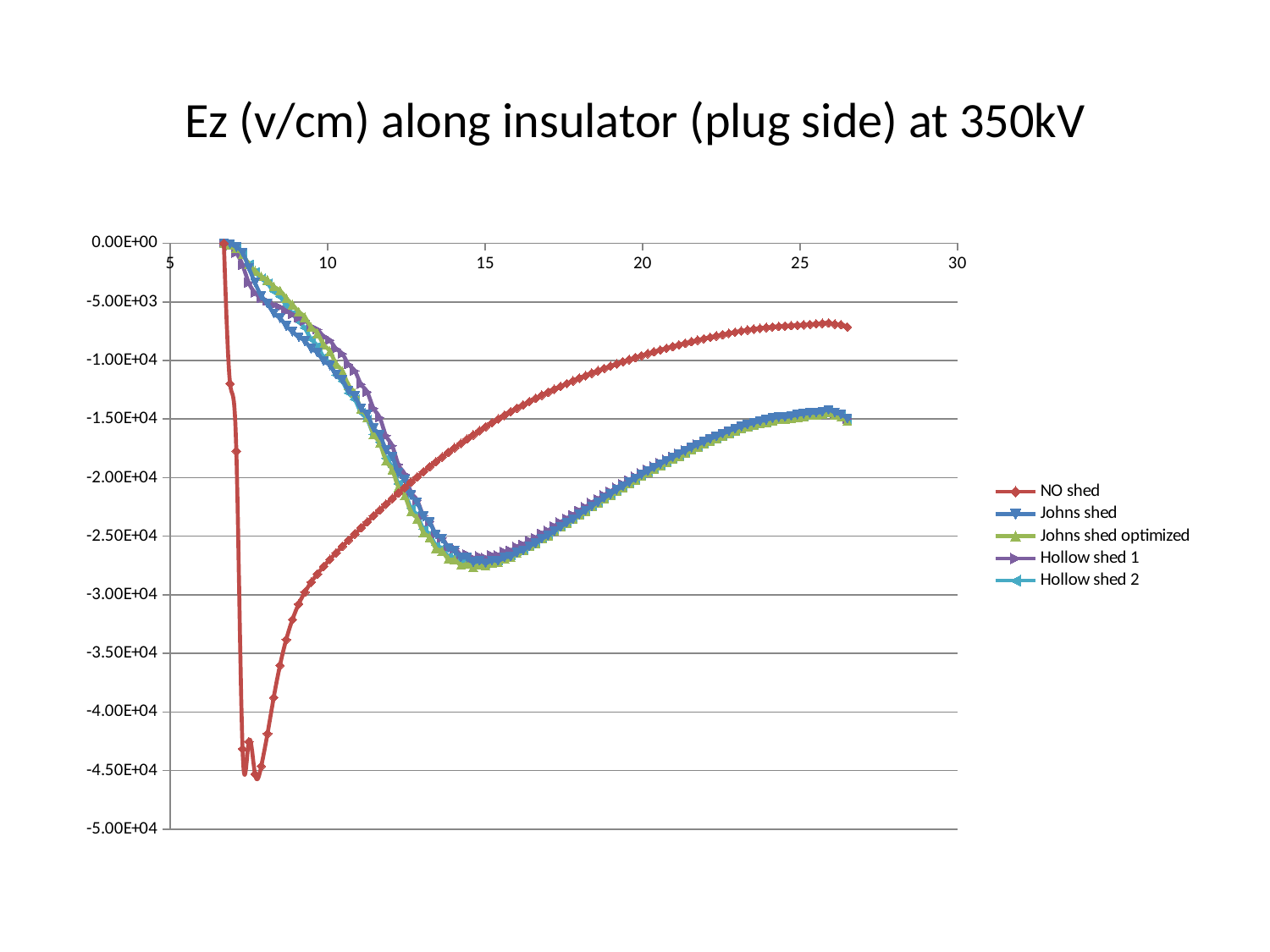
Is the lowest value of the NO shed series greater or less than -4.00E+04? less Which series reaches the lowest (most negative) value on the chart? NO shed Is the value of the NO shed series at x = 25 greater or less than -1.00E+04? greater Between x = 15 and x = 25, does the NO shed series rise or fall? rise At x = 25, which series has the higher value, NO shed or Johns shed? NO shed Is the value of the Johns shed series at x = 25 greater or less than -1.00E+04? less Which series is drawn in red? NO shed How many series does the legend list? 5 What is the title of the chart? Ez (v/cm) along insulator (plug side) at 350kV What kind of chart is shown on the slide? line chart At x = 10, which series has the higher value, NO shed or Johns shed? Johns shed